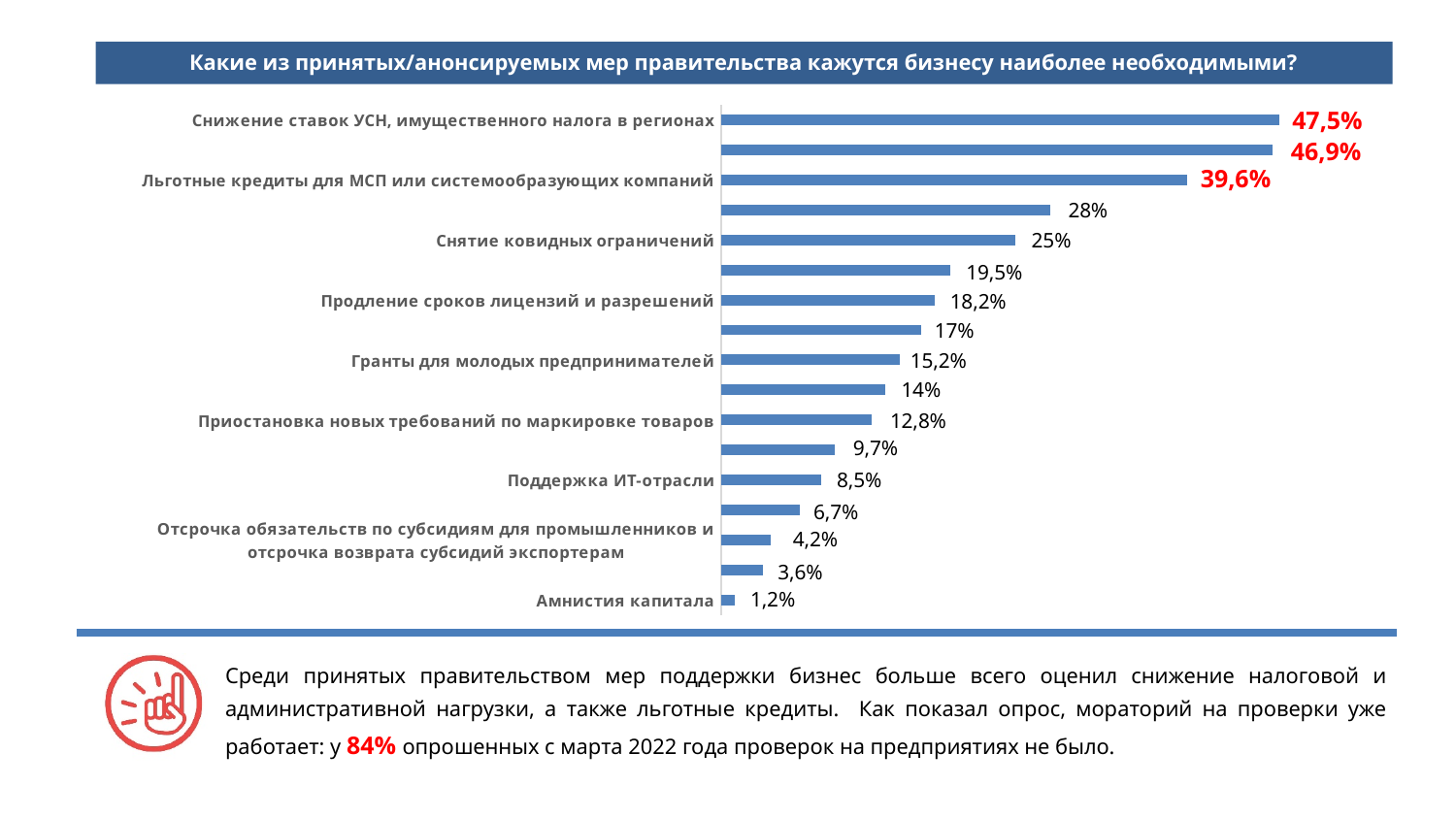
What is the value for «Льготные кредиты для МСП или системообразующих компаний»? 39,6% Which labelled measure has the highest value? Снижение ставок УСН, имущественного налога в регионах What is the difference between the values for «Снижение ставок УСН, имущественного налога в регионах» and «Льготные кредиты для МСП или системообразующих компаний»? 7,9 percentage points What is the value for «Снижение ставок УСН, имущественного налога в регионах»? 47,5% What is the value for «Амнистия капитала»? 1,2% Which labelled measure has the lowest value? Амнистия капитала What is the value for «Снятие ковидных ограничений»? 25% How many bars are plotted in the chart? 17 Do the bar values increase or decrease from the top of the chart to the bottom? Decrease What is the value for «Поддержка ИТ-отрасли»? 8,5% Which is larger: the value for «Снятие ковидных ограничений» or for «Продление сроков лицензий и разрешений»? Снятие ковидных ограничений What type of chart is shown on the slide? Bar chart